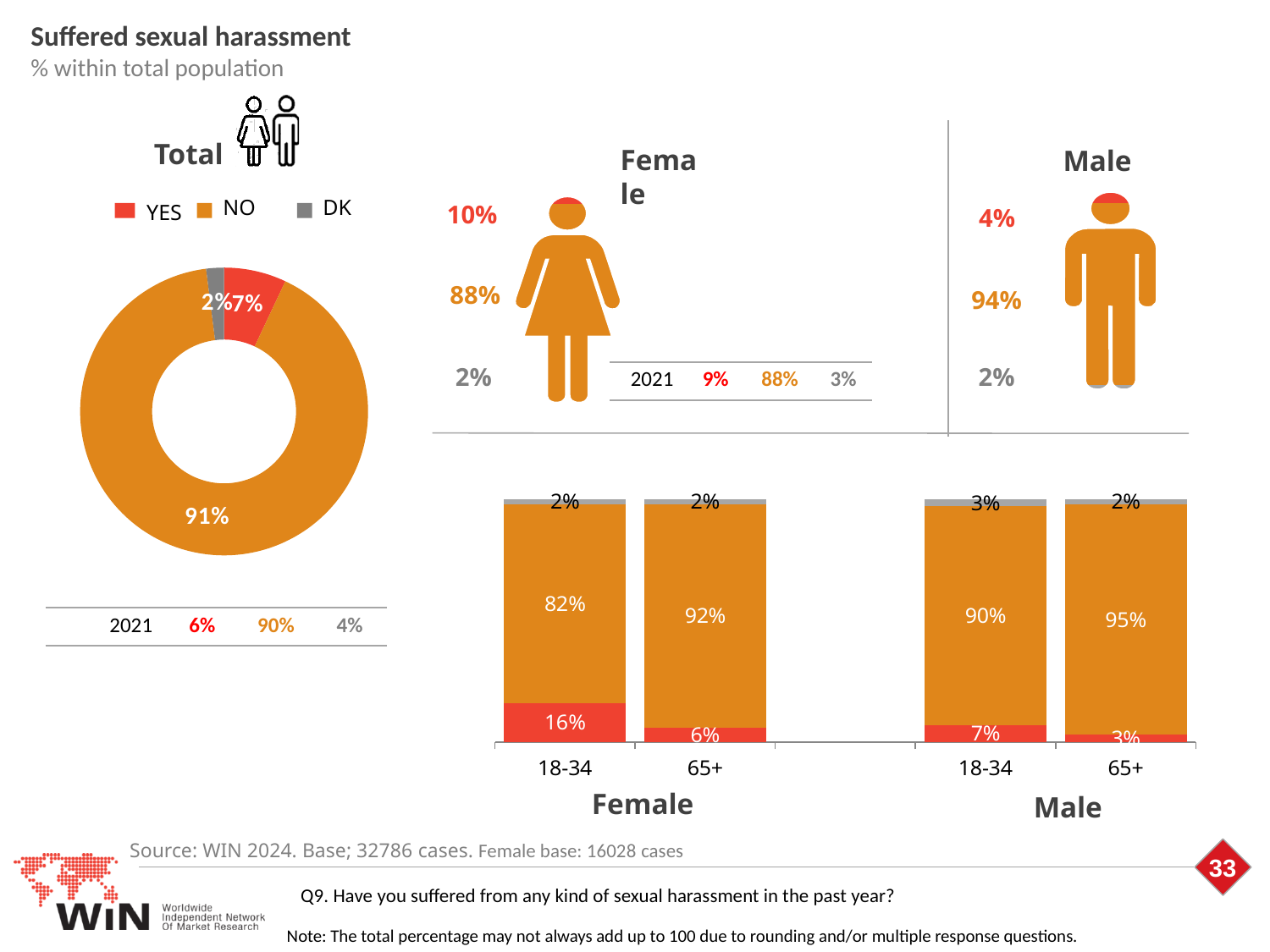
In the Female pictogram chart, what percentage answered YES in 2021? 9% In the Total donut chart, what percentage answered NO? 91% In the stacked bar chart by age group, which bar has the highest YES percentage? Female 18-34 In the stacked bar chart by age group, what is the NO percentage for Male 65+? 95% What kind of chart is the Total chart on the left of the slide? Donut chart In the stacked bar chart by age group, which bar has the lowest YES percentage? Male 65+ How many series does the legend of the Total donut chart list? 3 In the Total donut chart, what percentage answered YES? 7% How many bars are in the stacked bar chart by age group? 4 In the stacked bar chart by age group, which is larger: the NO percentage for Female 65+ or for Male 18-34? Female 65+ In the stacked bar chart by age group, what is the difference between the YES percentages for Female 18-34 and Female 65+? 10% In the stacked bar chart by age group, what is the YES percentage for Female 18-34? 16%